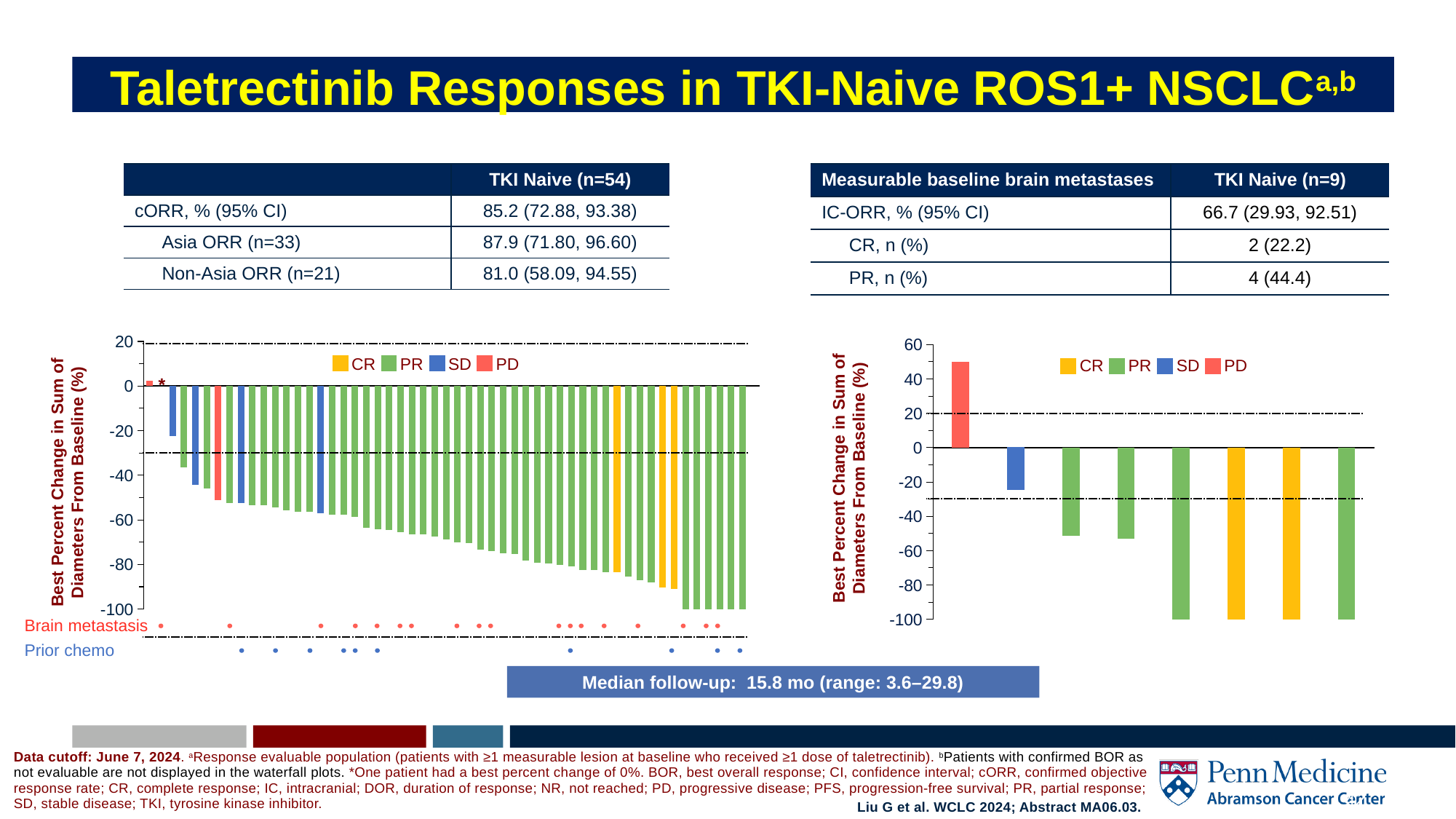
In the right chart, is the value of the red PD bar greater or less than 40? greater What type of chart is shown on the left side of the slide? bar chart In the right chart, which response category has the only bar above zero? PD What is the y-axis label of the left chart? Best Percent Change in Sum of Diameters From Baseline (%) In the right chart, how many bars are coloured yellow (CR)? 2 In the left chart, do the bar values rise or fall from left to right? fall What are the legend entries of the right chart? CR, PR, SD, PD In the left chart, how many bars are coloured yellow (CR)? 3 In the left chart, how many bars are coloured red (PD)? 2 In the right chart, is the value of the blue SD bar greater or less than -40? greater How many series does the legend of the left chart list? 4 In the right chart, what value do the two yellow CR bars reach on the y axis? -100